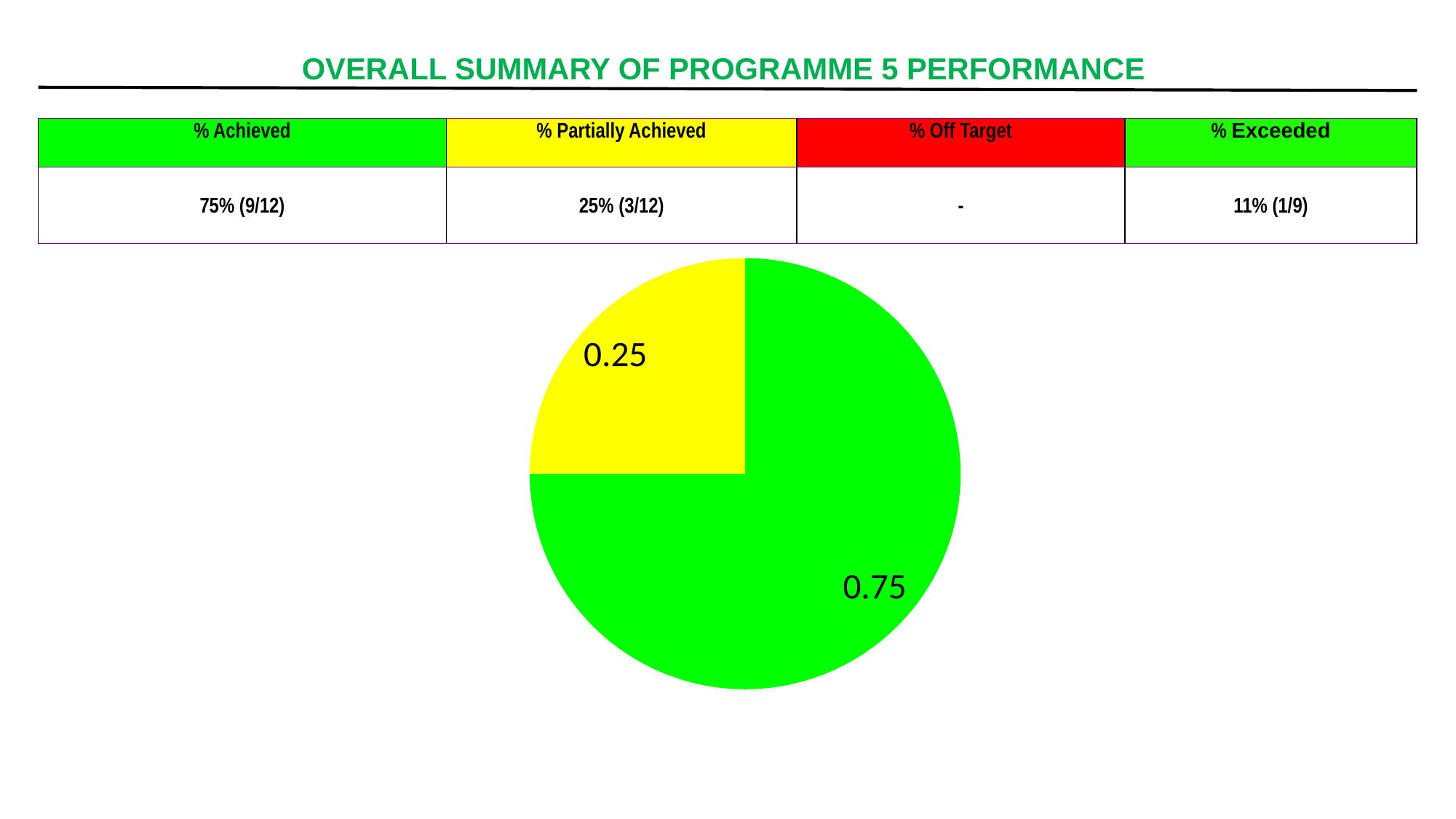
What share of the pie does the green slice represent? 75% How many slices does the pie chart have? 2 What value is labelled on the green slice of the pie chart? 0.75 What is the total of the two slice values shown on the pie chart? 1 What value is labelled on the yellow slice of the pie chart? 0.25 Which slice of the pie chart is the smallest? the yellow slice (0.25) What share of the pie does the yellow slice represent? 25% What colours are used for the two slices of the pie chart? green and yellow What kind of chart is shown on the slide? pie chart What is the difference between the green slice value and the yellow slice value in the pie chart? 0.5 Which is larger in the pie chart, the green slice or the yellow slice? the green slice Which slice of the pie chart is the largest? the green slice (0.75)